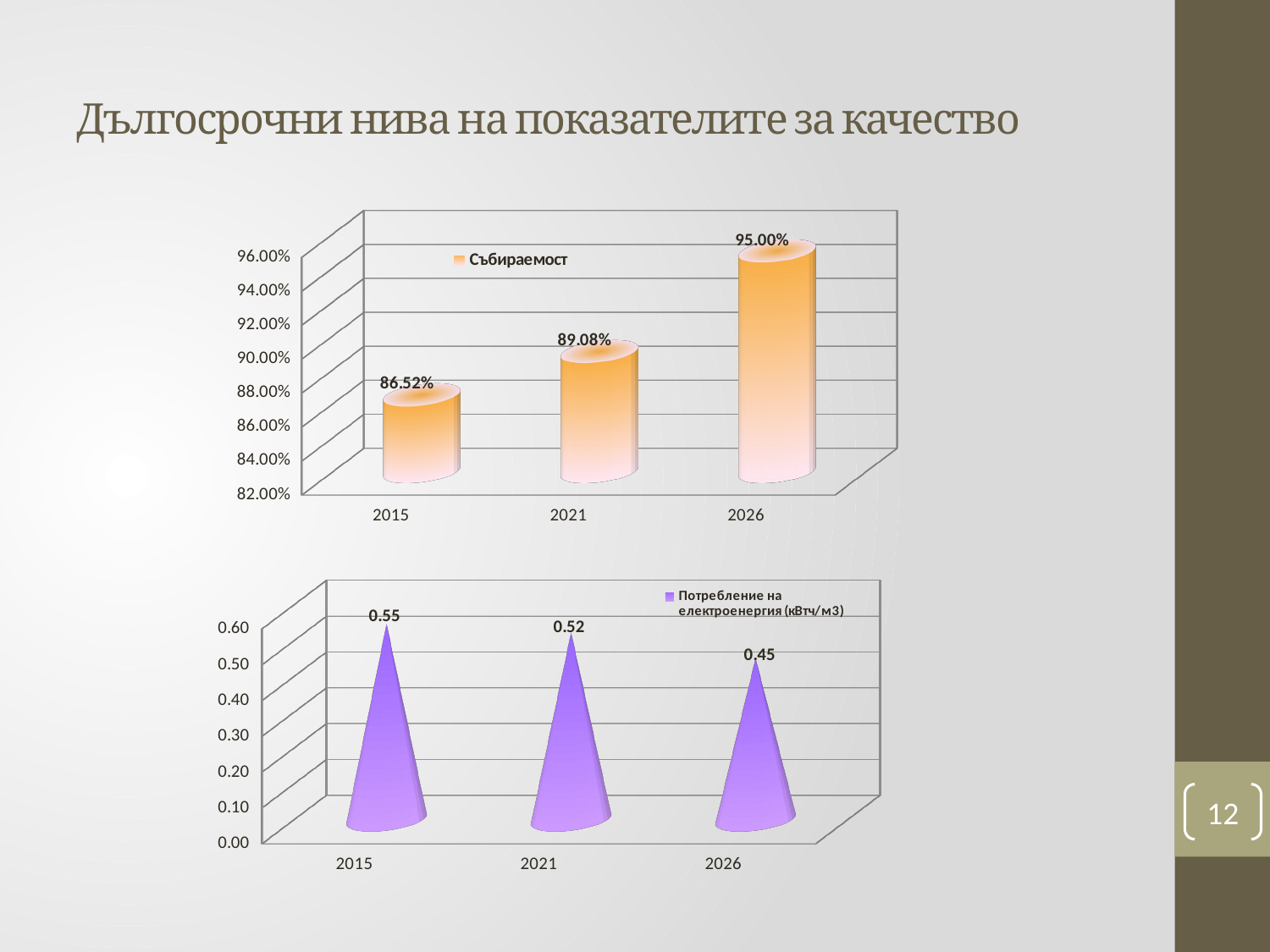
How many years are shown on the x axis of the top chart? 3 In the top chart, which year has the highest value? 2026 In the top chart, what is the difference between the values for 2026 and 2015? 8.48% In the bottom chart, what is the value for 2015? 0.55 Do the values in the bottom chart rise or fall from 2015 to 2026? fall What is the legend entry of the top chart? Събираемост In the top chart, what is the value for 2021? 89.08% In the bottom chart, what is the value for 2026? 0.45 In the bottom chart, which year has the lowest value? 2026 In the bottom chart, which is larger, the value for 2021 or the value for 2026? 2021 In the top chart, what is the value for 2026? 95.00% In the bottom chart, what is the difference between the values for 2015 and 2021? 0.03